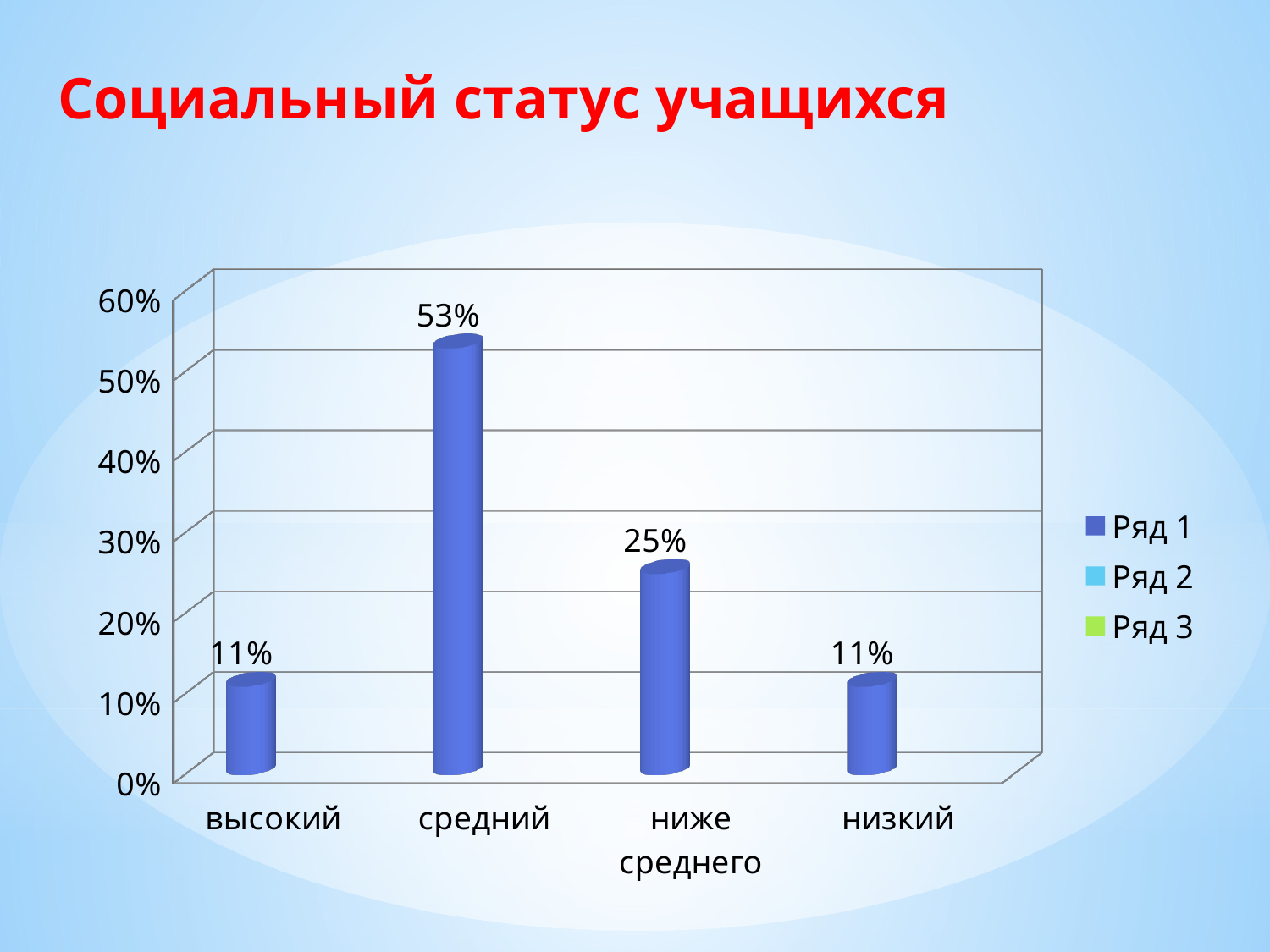
What is the title of the slide? Социальный статус учащихся Which category has the highest value? средний How many series does the legend list? 3 What kind of chart is shown on the slide? bar chart What is the difference between the values for ниже среднего and низкий? 14% What is the value for средний? 53% Which is larger, the value for средний or the value for ниже среднего? средний How many categories are shown on the x axis? 4 What is the value for ниже среднего? 25% What is the value for высокий? 11% What is the difference between the values for средний and ниже среднего? 28% Is the value for средний greater or less than 50%? greater